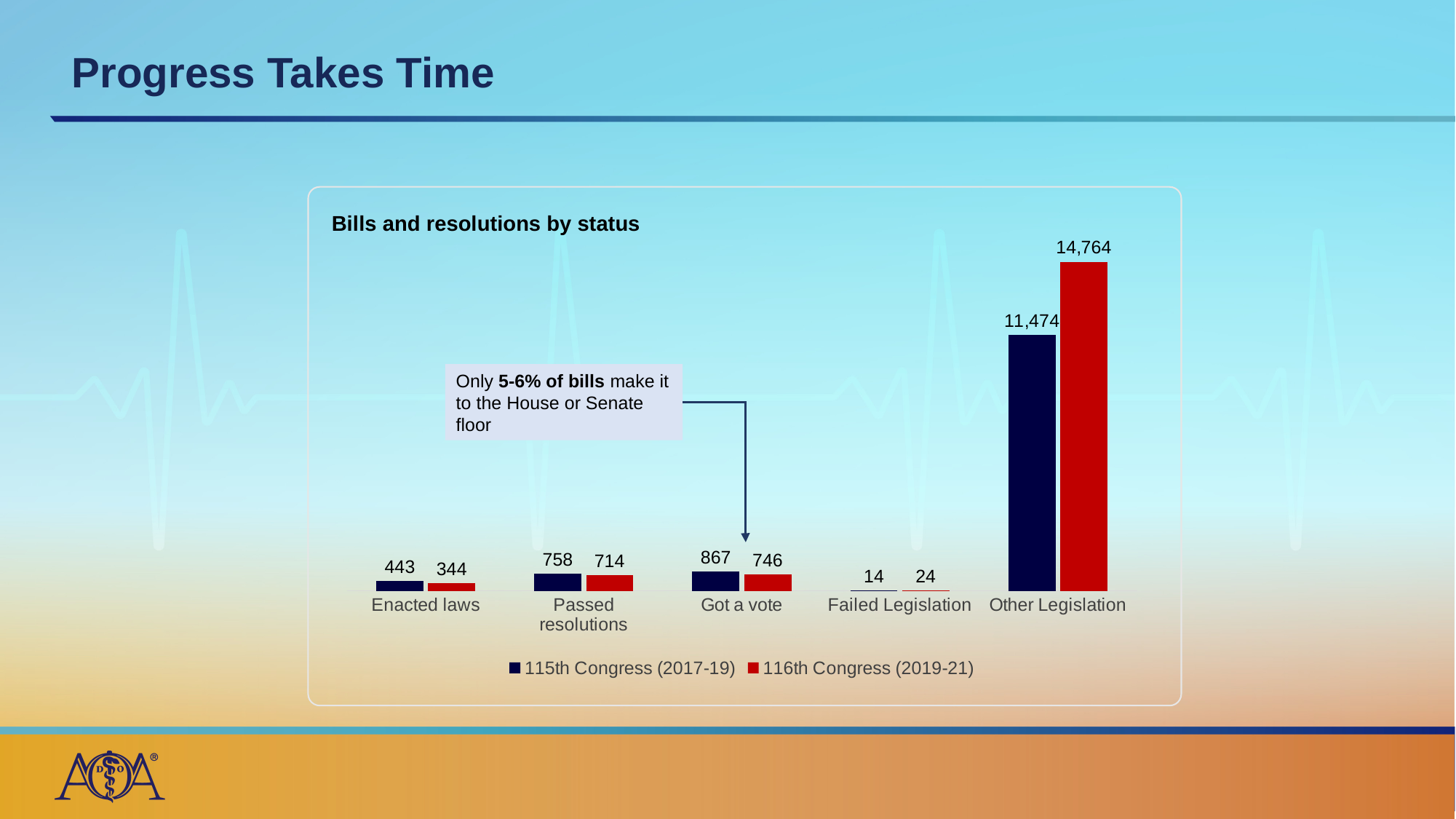
What is the value for Other Legislation in the 116th Congress (2019-21)? 14,764 Which category has the highest value for the 115th Congress (2017-19)? Other Legislation What is the value for Failed Legislation in the 116th Congress (2019-21)? 24 For Passed resolutions, which is larger: the 115th Congress (2017-19) value or the 116th Congress (2019-21) value? 115th Congress (2017-19) What is the title of the chart? Bills and resolutions by status Which category has the lowest value for the 116th Congress (2019-21)? Failed Legislation How many series does the legend list? 2 How many categories are shown on the x axis? 5 What is the difference between the 115th Congress and 116th Congress values for Got a vote? 121 What kind of chart is shown on the slide? Bar chart What is the difference between the 116th Congress and 115th Congress values for Other Legislation? 3,290 What is the value for Enacted laws in the 115th Congress (2017-19)? 443